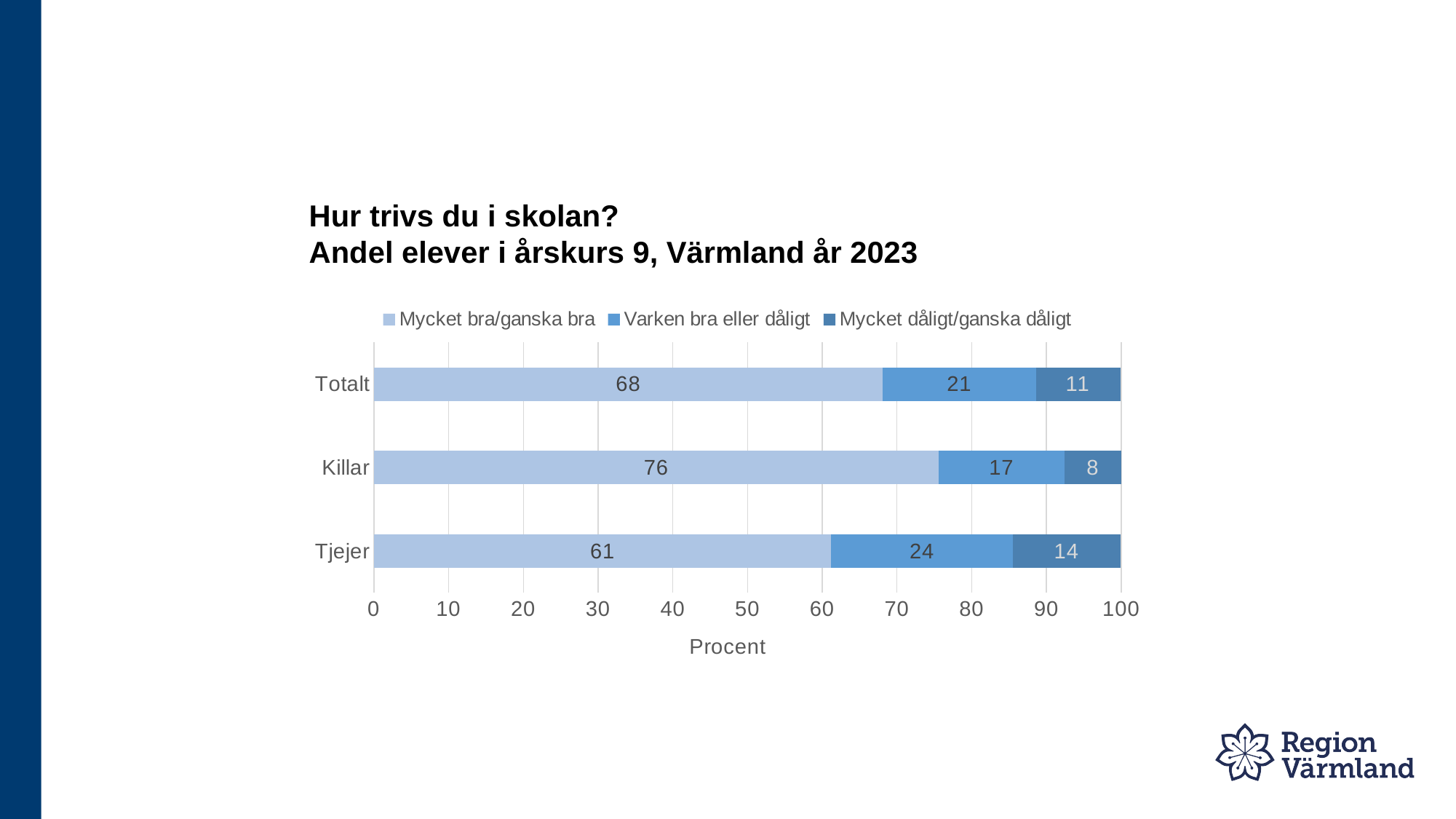
What is the label of the x axis? Procent What is the value for Tjejer in the Mycket dåligt/ganska dåligt series? 14 How many categories are shown on the y axis? 3 What kind of chart is shown on the slide? Stacked bar chart What is the value for Killar in the Mycket bra/ganska bra series? 76 What is the difference between the Mycket bra/ganska bra values for Killar and Tjejer? 15 What is the total of the stacked bar for Totalt? 100 What is the value for Totalt in the Varken bra eller dåligt series? 21 Which category has the highest value in the Mycket bra/ganska bra series? Killar Which category has the lowest value in the Mycket dåligt/ganska dåligt series? Killar Which is larger: the Varken bra eller dåligt value for Tjejer or for Killar? Tjejer How many series does the legend list? 3